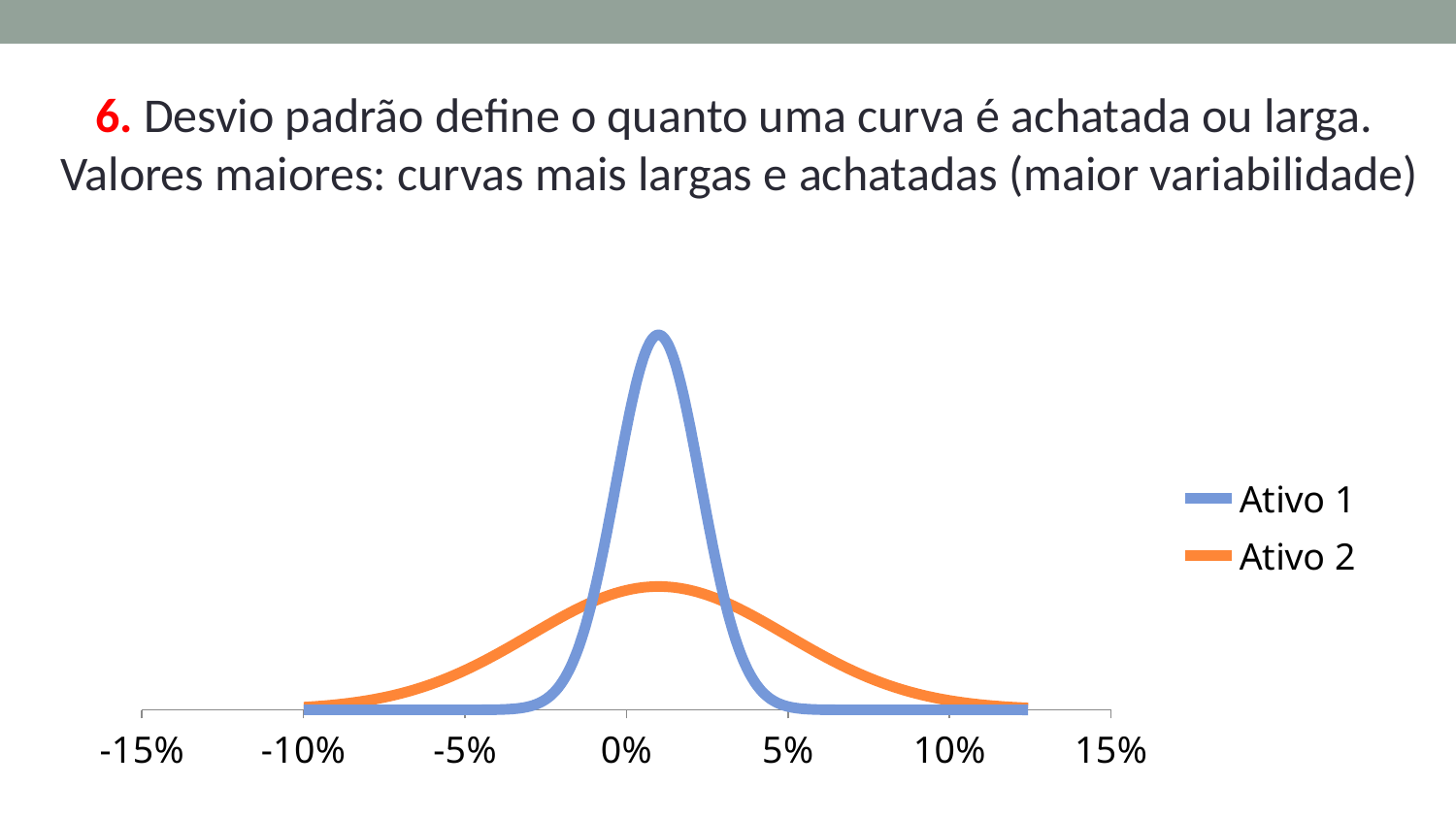
What kind of chart is shown on the slide? line chart Does the Ativo 2 curve rise or fall between -10% and 0% on the x axis? rise How many tick labels are shown on the x axis? 7 Which series reaches the higher peak, Ativo 1 or Ativo 2? Ativo 1 What is the lowest value labelled on the x axis? -15% Which series has the wider, flatter curve? Ativo 2 Which series is drawn in orange? Ativo 2 What are the names of the two series in the legend? Ativo 1 and Ativo 2 What is the highest value labelled on the x axis? 15% How many series does the legend list? 2